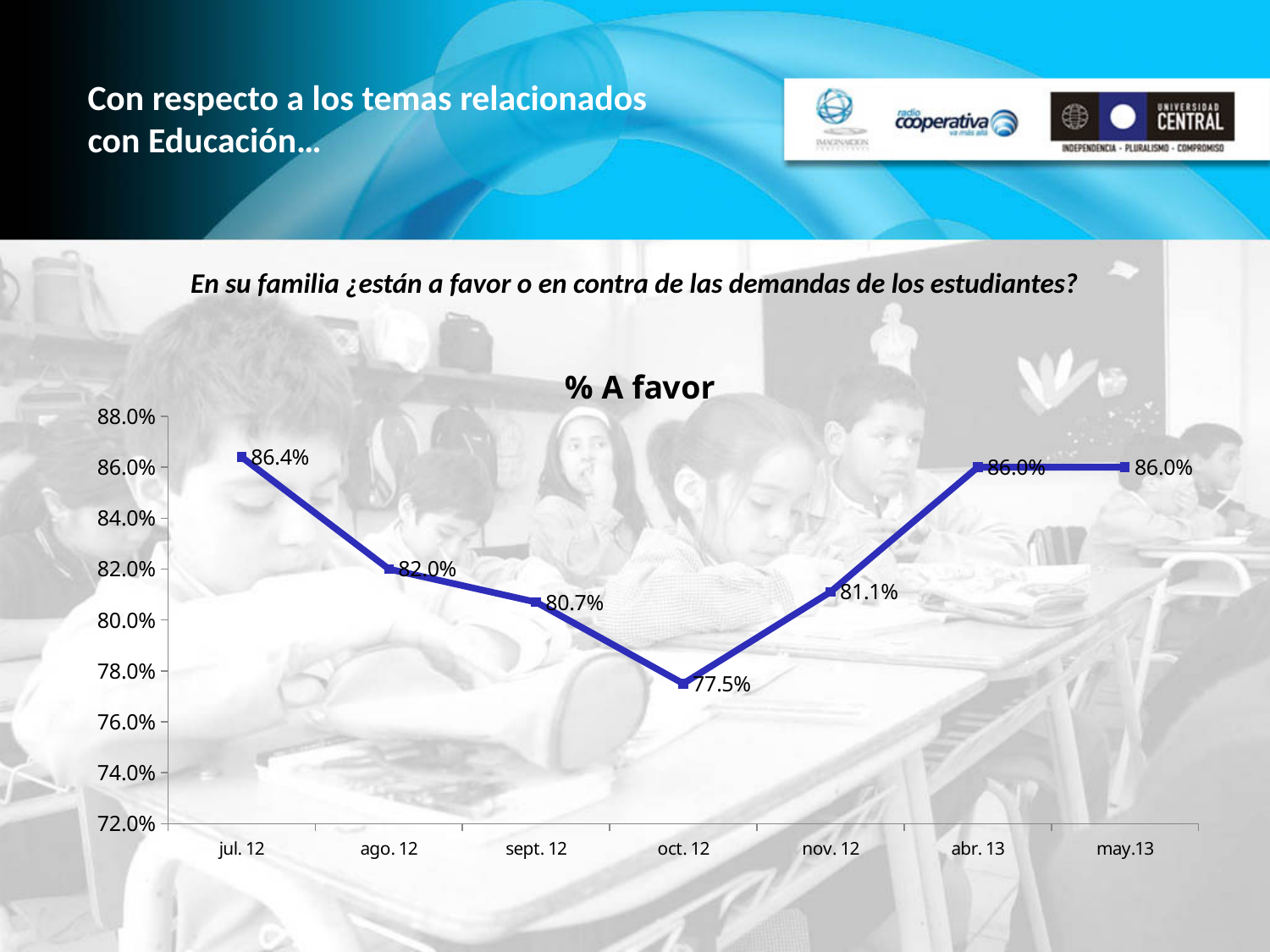
Which period has the highest value? jul. 12 What is the value for oct. 12? 77.5% Is the value for oct. 12 greater or less than 80.0%? less What is the value for jul. 12? 86.4% Which is larger, the value for ago. 12 or the value for nov. 12? ago. 12 What is the value for sept. 12? 80.7% What is the difference between the values for jul. 12 and oct. 12? 8.9% Which period has the lowest value? oct. 12 How many periods are plotted on the x axis? 7 What kind of chart is shown? line chart What is the value for nov. 12? 81.1% What is the title of the chart? % A favor